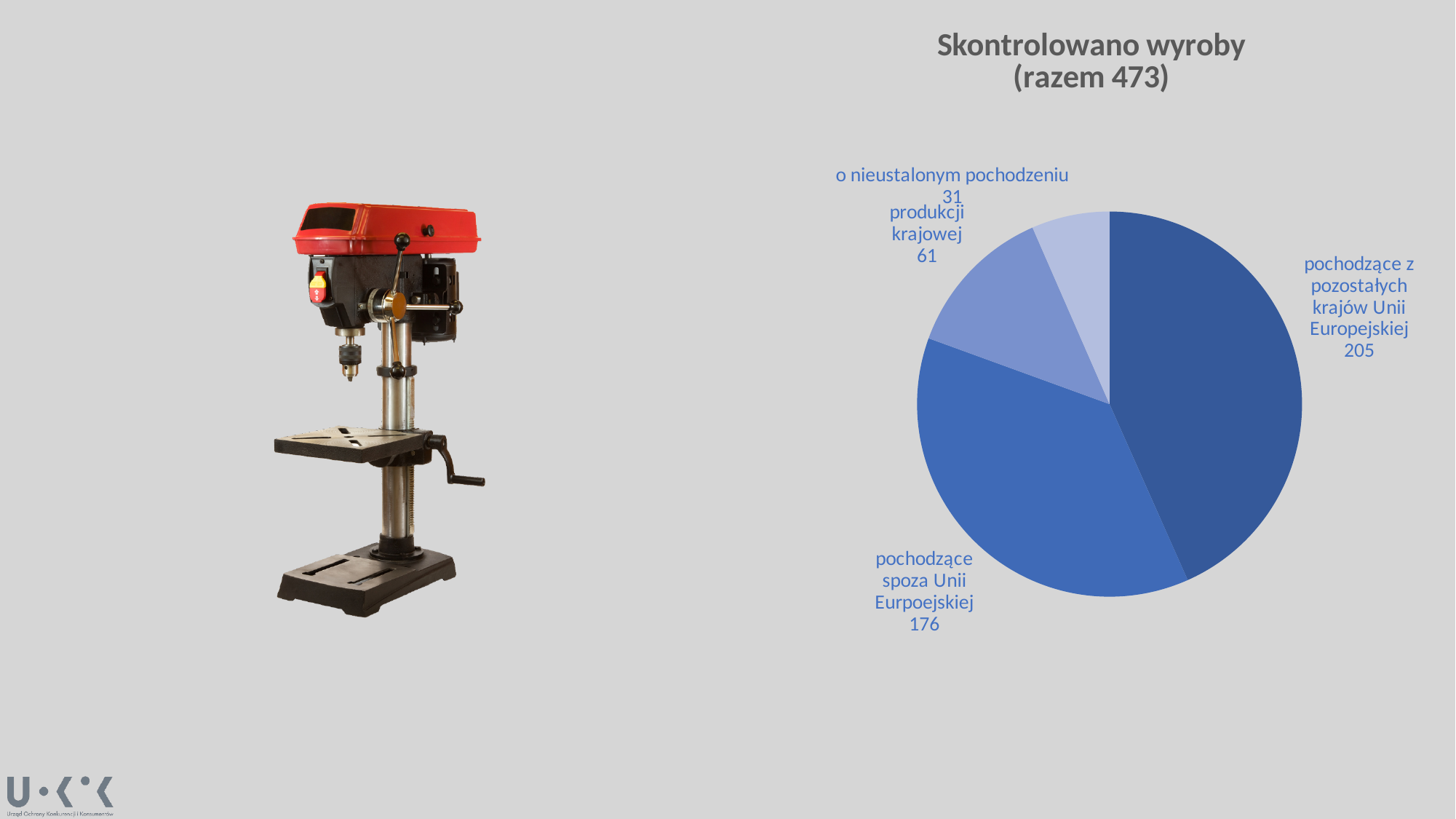
What is the value for 'pochodzące spoza Unii Eurpoejskiej'? 176 Which category has the smallest slice? o nieustalonym pochodzeniu What is the value for 'o nieustalonym pochodzeniu'? 31 Which category has the largest slice? pochodzące z pozostałych krajów Unii Europejskiej What share of the total (473) does 'produkcji krajowej' represent, to the nearest whole percent? 13% What is the title of the chart? Skontrolowano wyroby (razem 473) What is the value for 'produkcji krajowej'? 61 Which is larger: 'produkcji krajowej' or 'o nieustalonym pochodzeniu'? produkcji krajowej What kind of chart is shown on the slide? pie chart What is the value for 'pochodzące z pozostałych krajów Unii Europejskiej'? 205 What is the difference between the values for 'pochodzące z pozostałych krajów Unii Europejskiej' and 'pochodzące spoza Unii Eurpoejskiej'? 29 How many slices does the pie chart have? 4